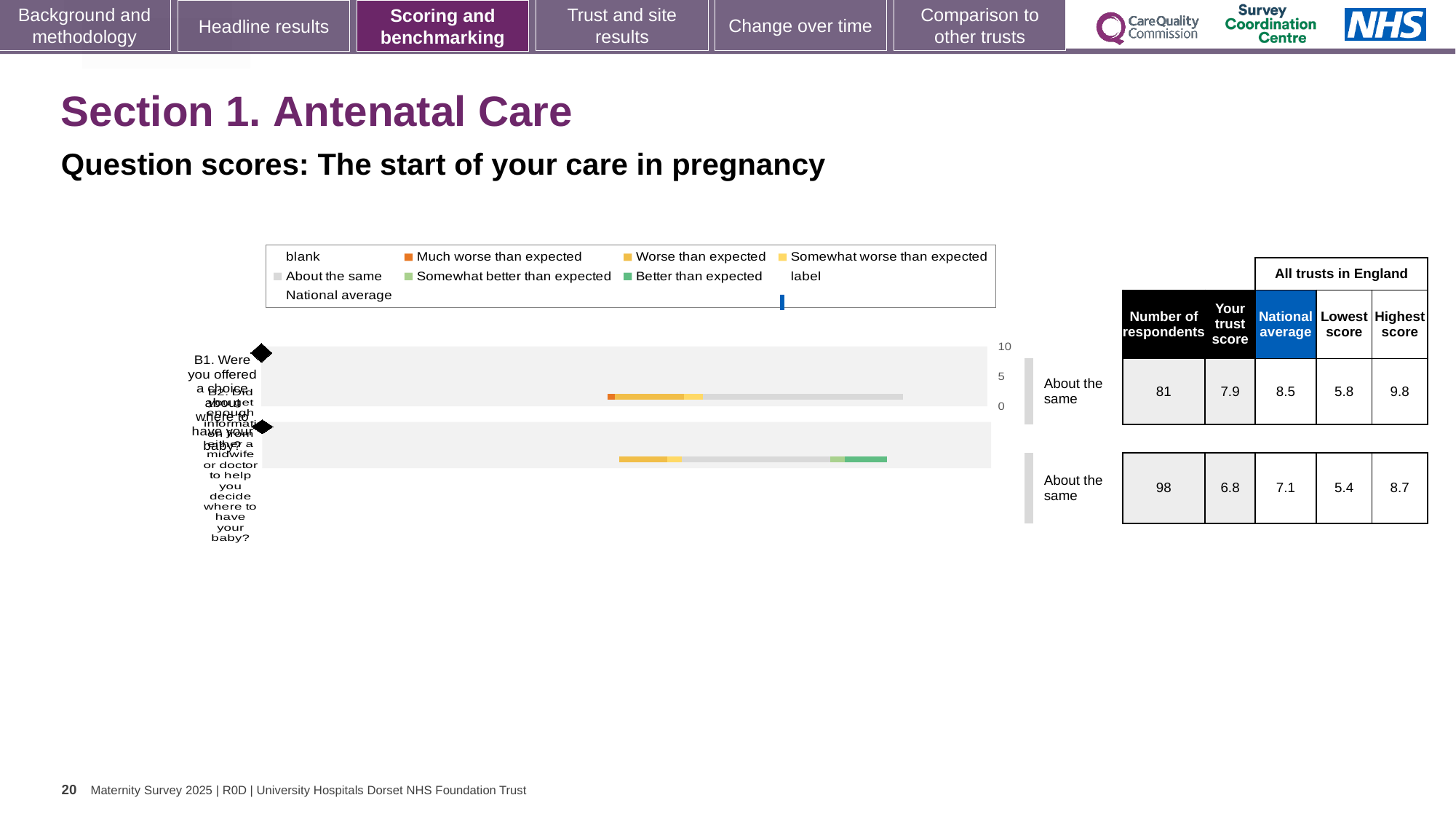
What is the lowest score across all trusts in England for question B2? 5.4 How many respondents answered question B2? 98 What is the difference between the national average and the trust score for question B1? 0.6 How is the trust's result for question B2 categorised relative to expectation? About the same What is the trust score for question B1 (Were you offered a choice about where to have your baby)? 7.9 What is the maximum value shown on the chart's score axis? 10 How many questions (categories) are plotted in the chart? 2 What is the national average for question B2? 7.1 What is the highest score across all trusts in England for question B1? 9.8 How many respondents answered question B1? 81 Which question has the higher trust score, B1 or B2? B1 What kind of chart is shown on the slide? bar chart